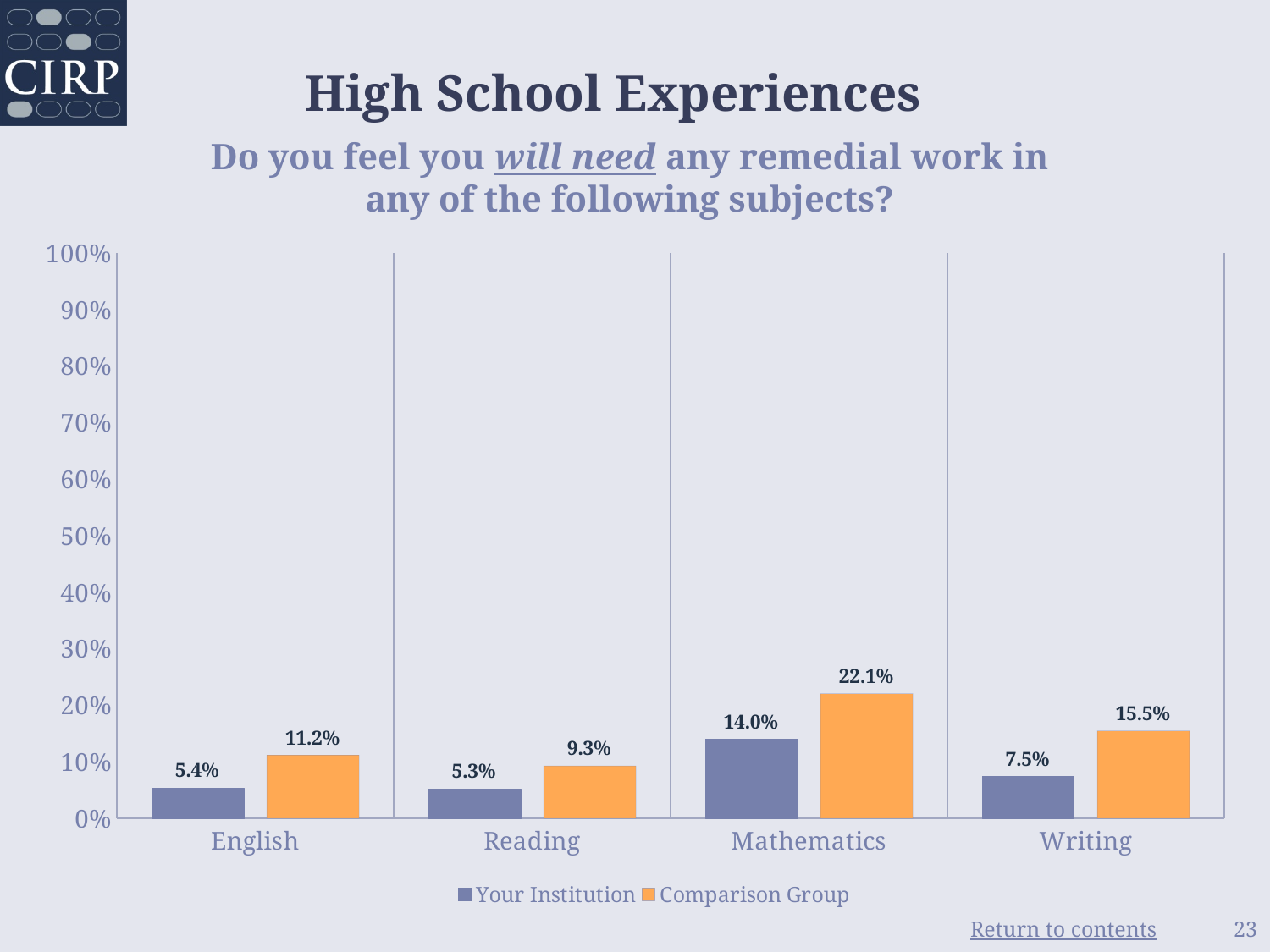
Which subject has the highest Comparison Group value? Mathematics Is the Comparison Group value for Mathematics greater or less than 20%? greater What is the value for Your Institution in Reading? 5.3% Which is larger for Writing: Your Institution or the Comparison Group? Comparison Group What is the difference between the Comparison Group and Your Institution values for Mathematics? 8.1% What kind of chart is shown on the slide? Bar chart How many subjects are shown on the x axis? 4 What is the value for the Comparison Group in Writing? 15.5% What is the value for Your Institution in Mathematics? 14.0% What is the difference between the Comparison Group and Your Institution values for English? 5.8% How many series does the legend list? 2 Which subject has the lowest Your Institution value? Reading